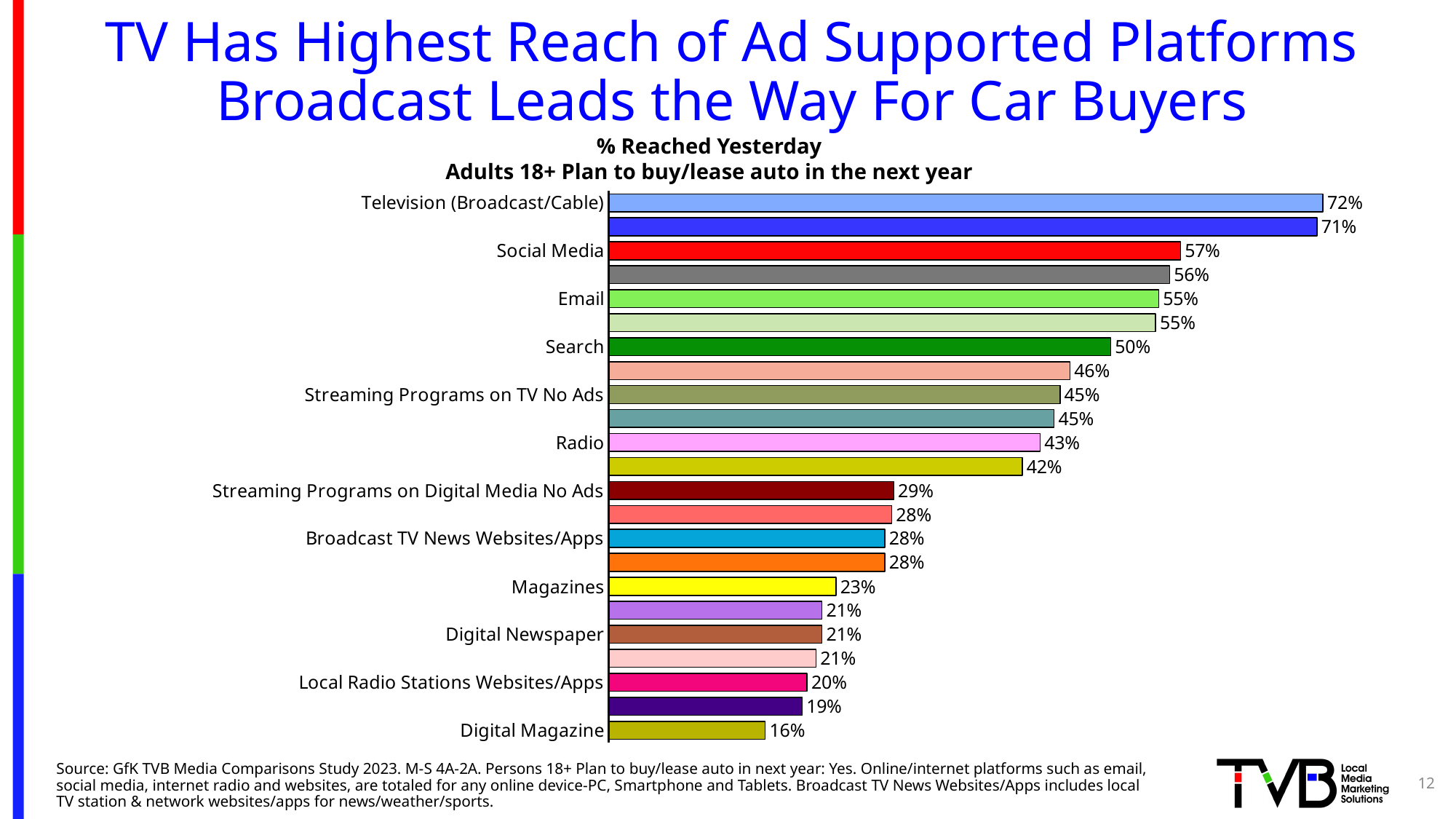
Which has a higher value, Email or Streaming Programs on TV No Ads? Email Which has a higher value, Magazines or Digital Newspaper? Magazines What percentage of adults 18+ planning to buy/lease an auto were reached yesterday by Television (Broadcast/Cable)? 72% What type of chart is shown on the slide? Bar chart Which labeled platform has the highest % reached yesterday? Television (Broadcast/Cable) How many bars are plotted in the chart? 23 Which labeled platform has the lowest % reached yesterday? Digital Magazine What is the difference between the values for Search and Radio? 7% What is the value shown for Social Media? 57% What is the value shown for Radio? 43% What is the difference between the values for Television (Broadcast/Cable) and Social Media? 15% What is the value shown for Digital Magazine? 16%